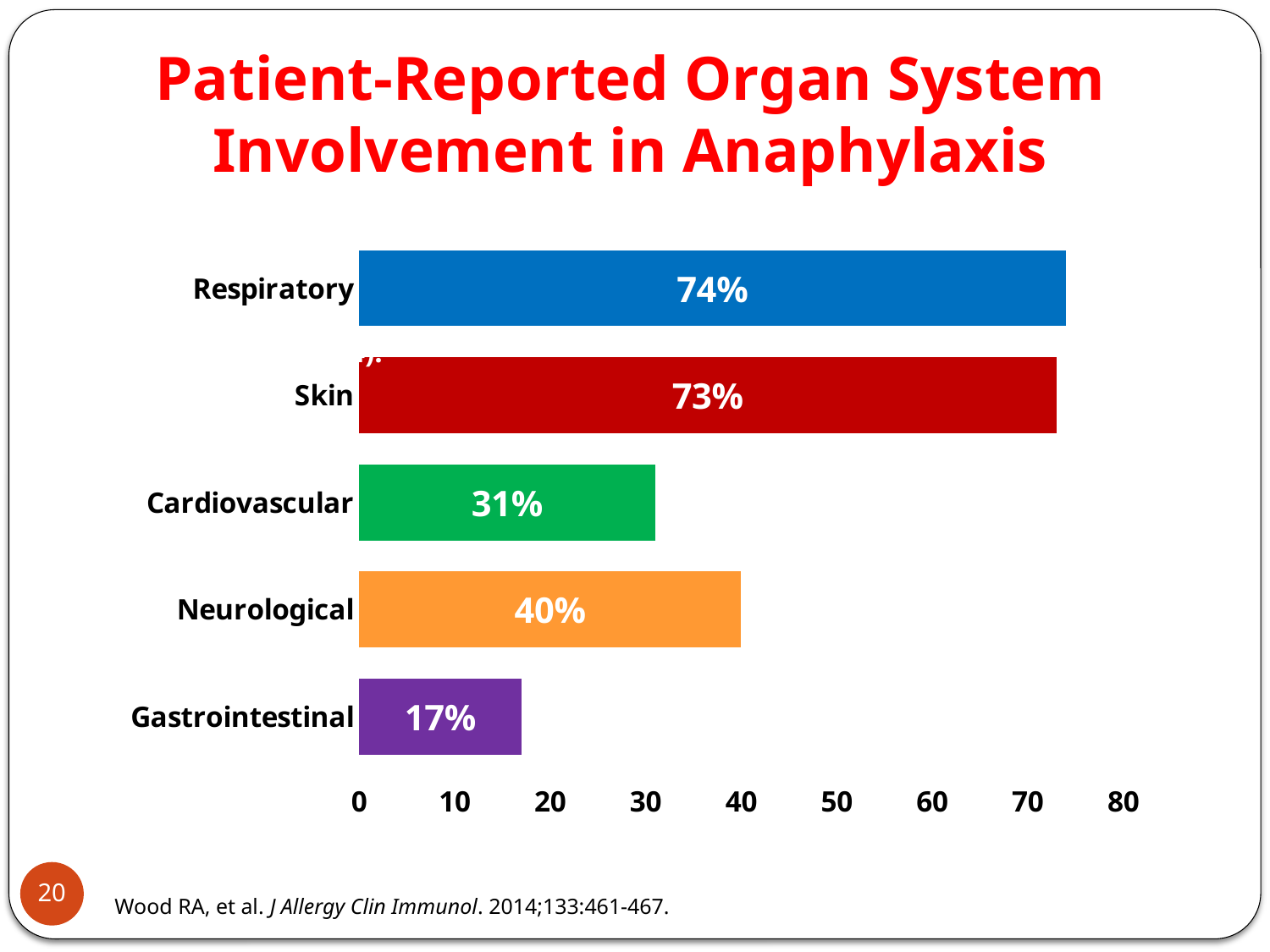
What is the difference between the values for Respiratory and Gastrointestinal? 57% What is the value for Cardiovascular? 31% How many organ system categories are shown in the chart? 5 What is the title of the slide? Patient-Reported Organ System Involvement in Anaphylaxis What is the difference between the values for Neurological and Cardiovascular? 9% What is the value for Neurological? 40% What is the value for Respiratory? 74% Which organ system has the lowest value? Gastrointestinal What is the value for Gastrointestinal? 17% What kind of chart is shown on the slide? Bar chart What is the value for Skin? 73% Which is larger, the value for Neurological or the value for Cardiovascular? Neurological